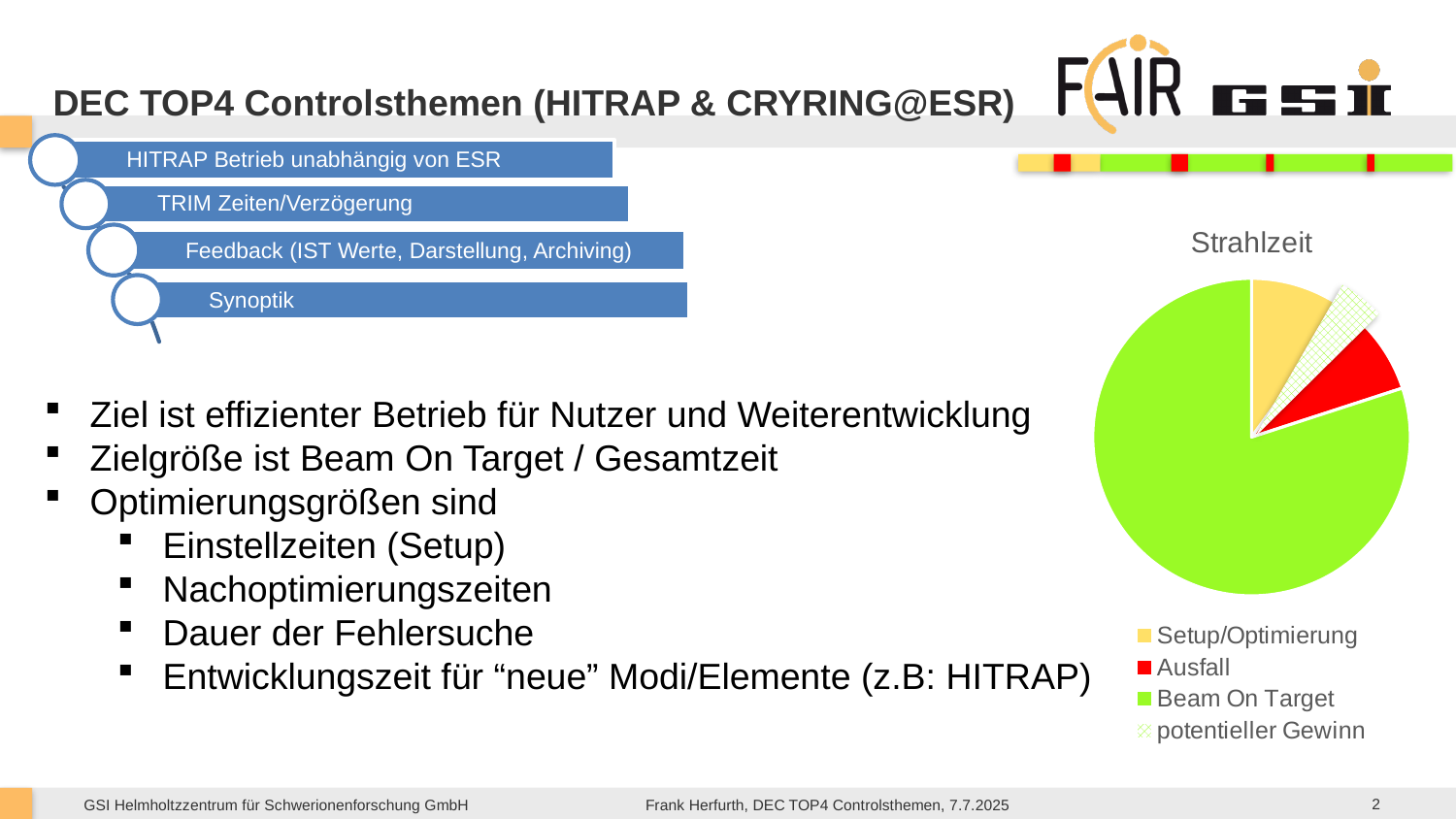
Which slice is larger, Beam On Target or Setup/Optimierung? Beam On Target What is the title of the chart? Strahlzeit Which slice is larger, Beam On Target or Ausfall? Beam On Target Which slice is larger, Beam On Target or potentieller Gewinn? Beam On Target What kind of chart is shown on the slide? pie chart Which category has the largest slice of the pie chart? Beam On Target How many categories does the legend of the pie chart list? 4 Which category is shown in red in the pie chart? Ausfall Does the Beam On Target slice make up more or less than half of the pie? more